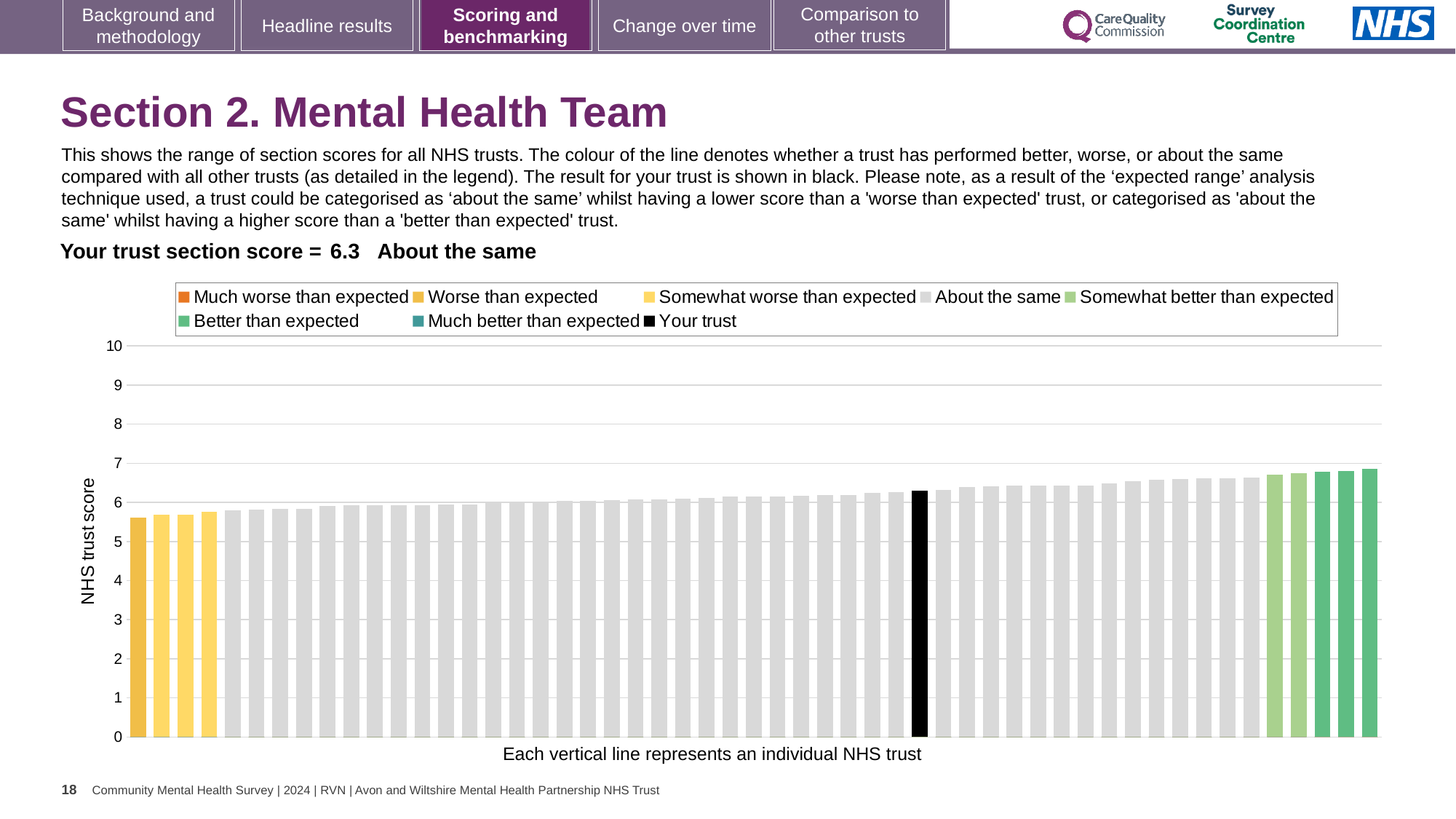
Is the value of the rightmost (highest) bar greater or less than 7? less What colour is used for the bar representing your trust? Black Is the value of the leftmost (lowest) bar greater or less than 6? less Is the value of the black bar (your trust) greater or less than 6? greater What is the label on the vertical axis of the chart? NHS trust score Do the bar values rise or fall moving from left to right along the x axis? rise How many entries does the chart legend list? 8 What is the section score for your trust shown on the slide? 6.3 Which is larger, the leftmost bar or the rightmost bar? the rightmost bar Which benchmarking category is your trust placed in for this section? About the same What kind of chart is shown on the slide? Bar chart